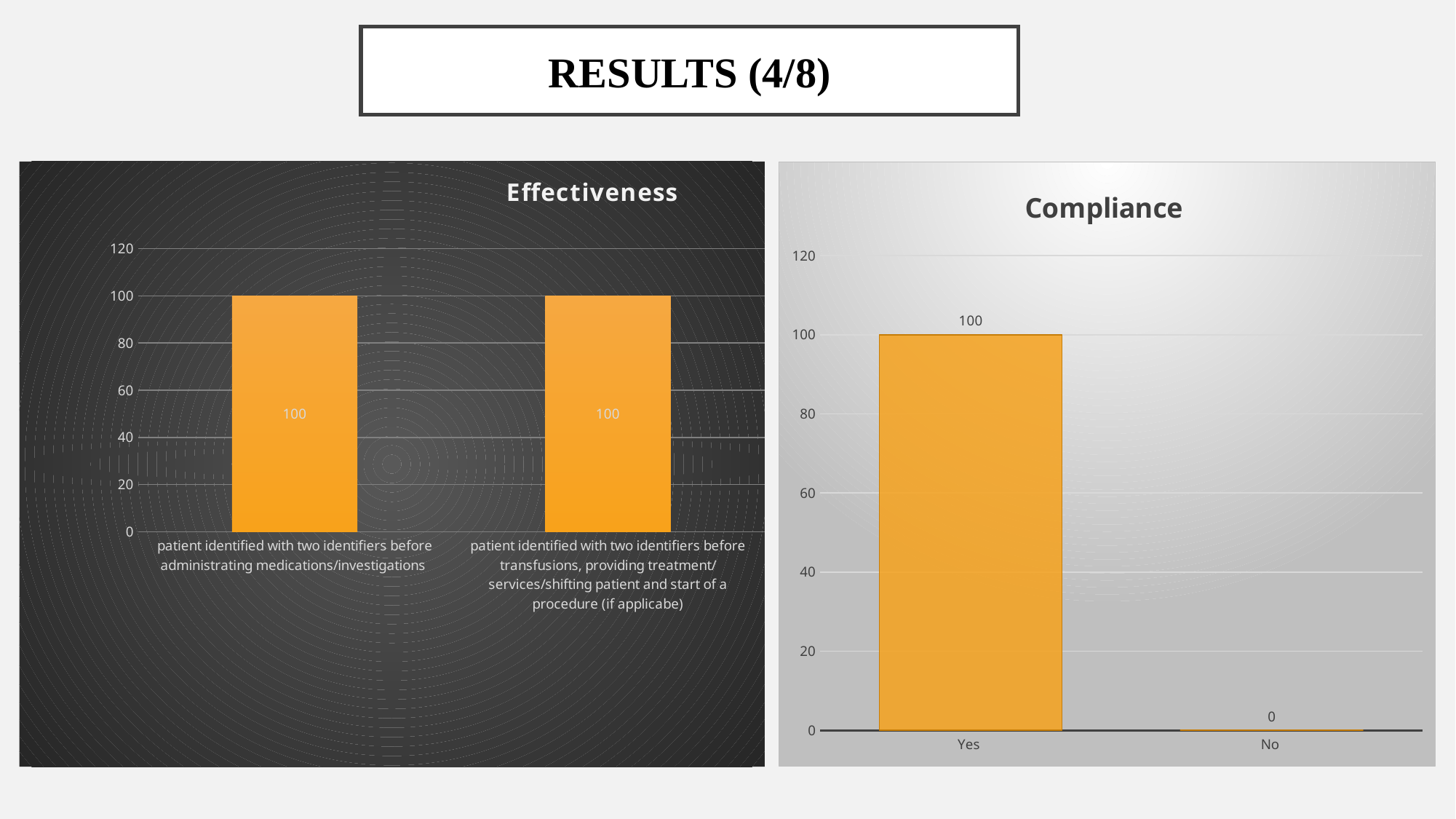
How many categories are shown in the Effectiveness chart? 2 What is the title of the chart on the left side of the slide? Effectiveness In the Compliance chart, what is the value for 'Yes'? 100 In the Compliance chart, which is larger, the value for 'Yes' or the value for 'No'? Yes In the Compliance chart, what is the difference between the values for 'Yes' and 'No'? 100 How many categories are shown in the Compliance chart? 2 In the Effectiveness chart, what is the value for 'patient identified with two identifiers before transfusions, providing treatment/services/shifting patient and start of a procedure (if applicabe)'? 100 What kind of chart is the Compliance chart? Bar chart In the Effectiveness chart, what is the value for 'patient identified with two identifiers before administrating medications/investigations'? 100 In the Compliance chart, what is the value for 'No'? 0 In the Compliance chart, which category has the lowest value? No In the Compliance chart, which category has the highest value? Yes